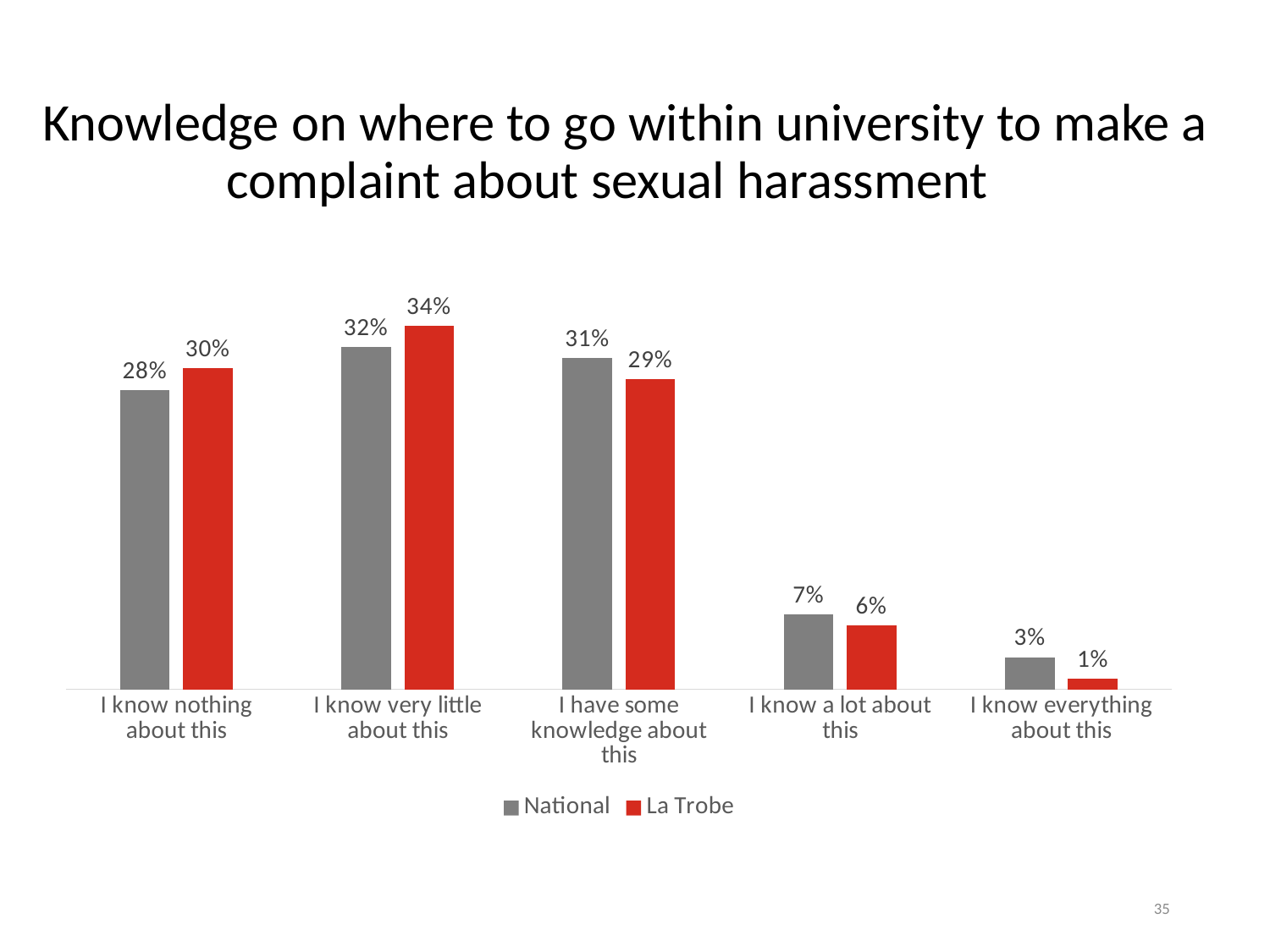
How many series does the legend list? 2 What is the difference between the National and La Trobe values for "I have some knowledge about this"? 2% Which category has the highest La Trobe value? I know very little about this Which series is shown in red? La Trobe What is the National value for "I know nothing about this"? 28% How many categories are shown on the x axis? 5 What is the difference between the La Trobe values for "I know nothing about this" and "I know everything about this"? 29% For "I know a lot about this", which is larger: the National value or the La Trobe value? National What is the La Trobe value for "I know everything about this"? 1% What kind of chart is shown on the slide? Bar chart Which category has the lowest National value? I know everything about this What is the La Trobe value for "I know very little about this"? 34%